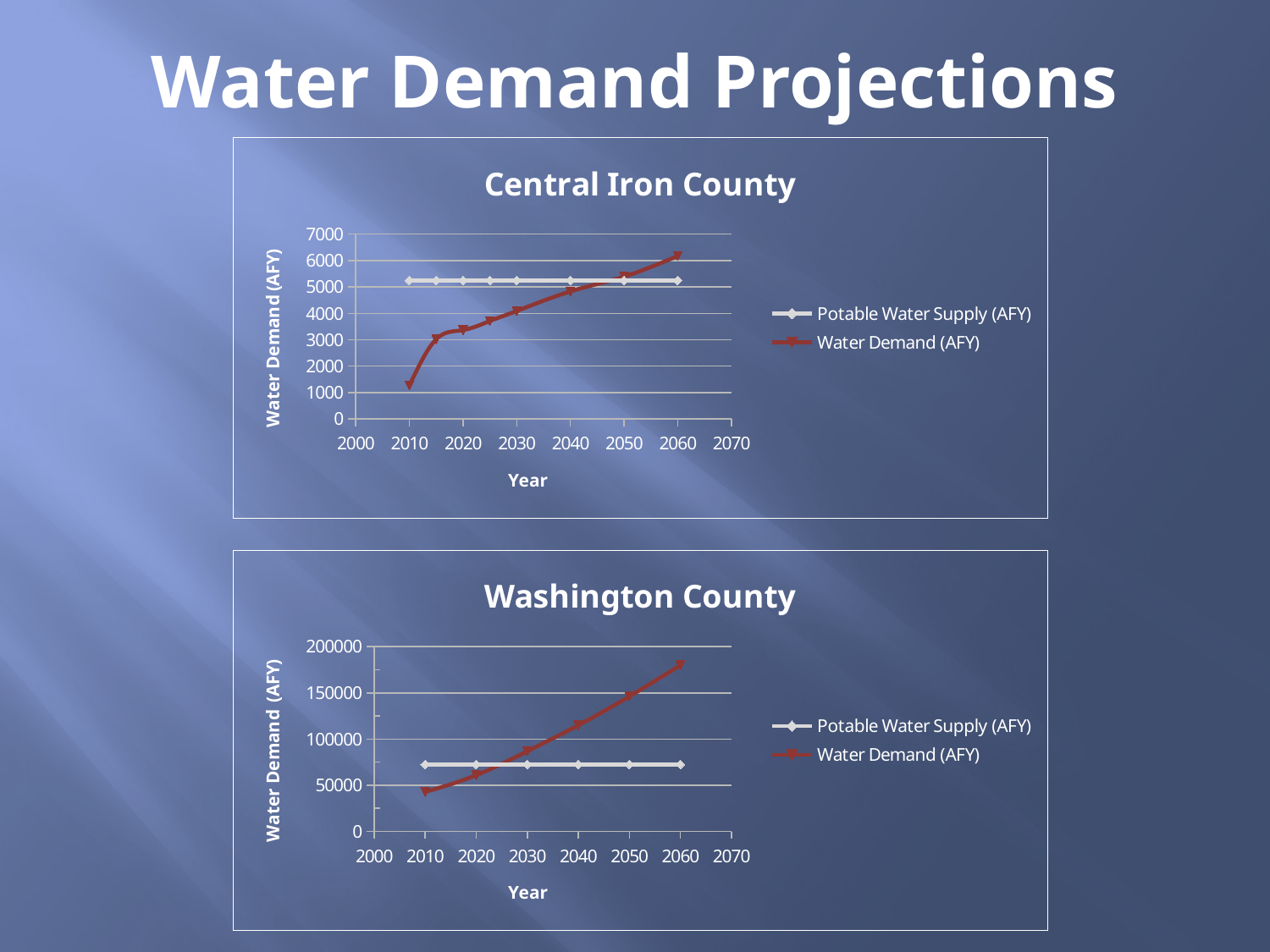
In the Central Iron County chart, is the Water Demand (AFY) value for 2010 greater or less than 2000? less In the Central Iron County chart, which series has the larger value in 2060, Potable Water Supply (AFY) or Water Demand (AFY)? Water Demand (AFY) What is the label of the x axis on the Washington County chart? Year In the Central Iron County chart, does Water Demand (AFY) rise or fall from 2010 to 2060? rise In the Washington County chart, does Water Demand (AFY) rise or fall from 2010 to 2060? rise What is the title of the top chart on the slide? Central Iron County In the Central Iron County chart, is the Potable Water Supply (AFY) value greater or less than 5000? greater In the Washington County chart, is the Water Demand (AFY) value for 2010 greater or less than 50000? less In the Washington County chart, which series has the larger value in 2010, Potable Water Supply (AFY) or Water Demand (AFY)? Potable Water Supply (AFY) How many series does the legend of the Washington County chart list? 2 What type of chart is the Central Iron County chart? line chart